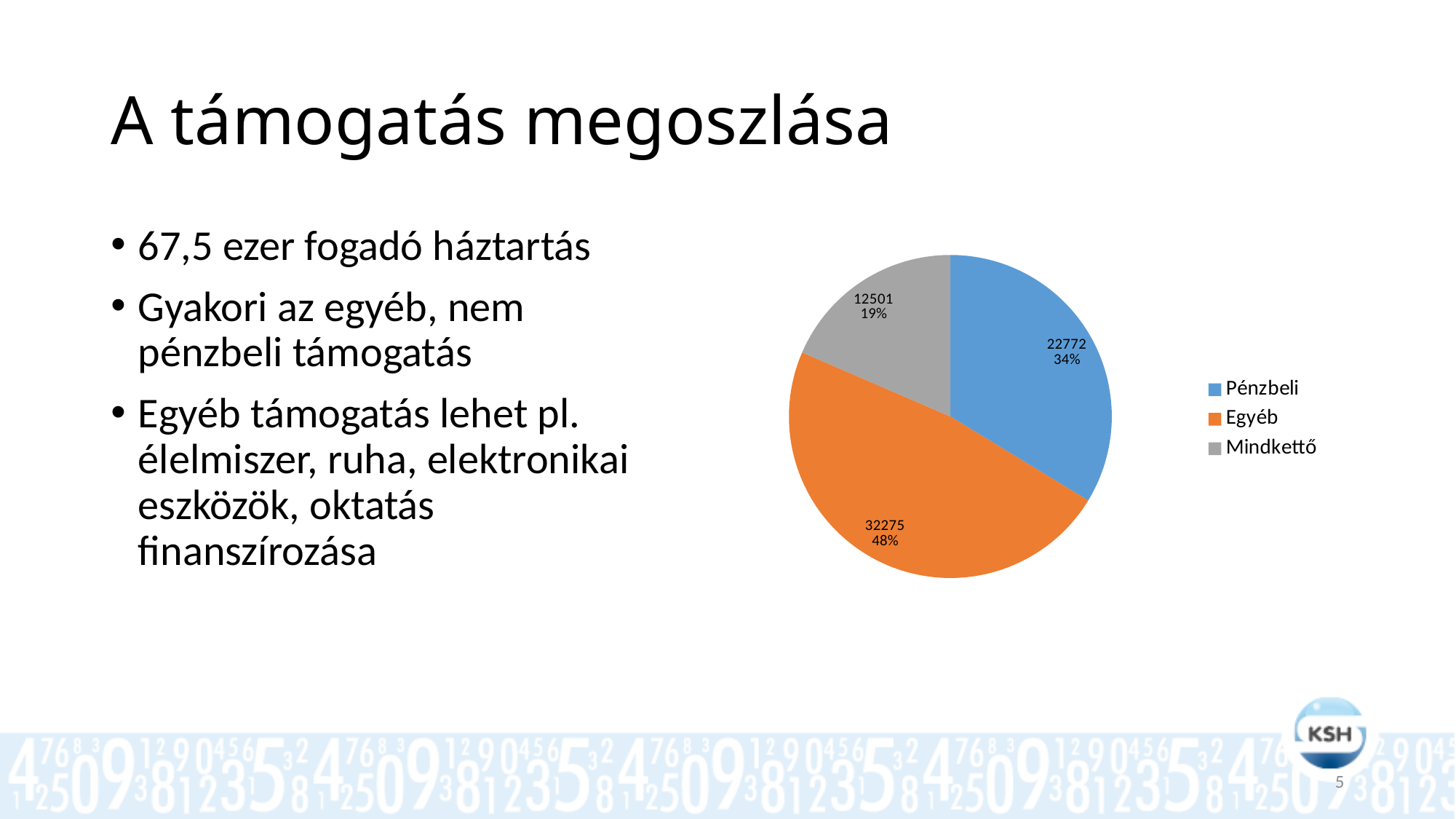
How many entries does the legend of the pie chart list? 3 What is the value shown for the Mindkettő slice? 12501 What is the value shown for the Pénzbeli slice? 22772 What is the value shown for the Egyéb slice? 32275 How many slices does the pie chart have? 3 What percentage share of the pie does the Egyéb slice have? 48% Which colour represents the Pénzbeli category in the pie chart? blue What kind of chart is shown on the slide? pie chart What percentage share of the pie does the Mindkettő slice have? 19% Which category has the largest slice of the pie? Egyéb Which category has the smallest slice of the pie? Mindkettő What is the difference between the values for Egyéb and Pénzbeli? 9503